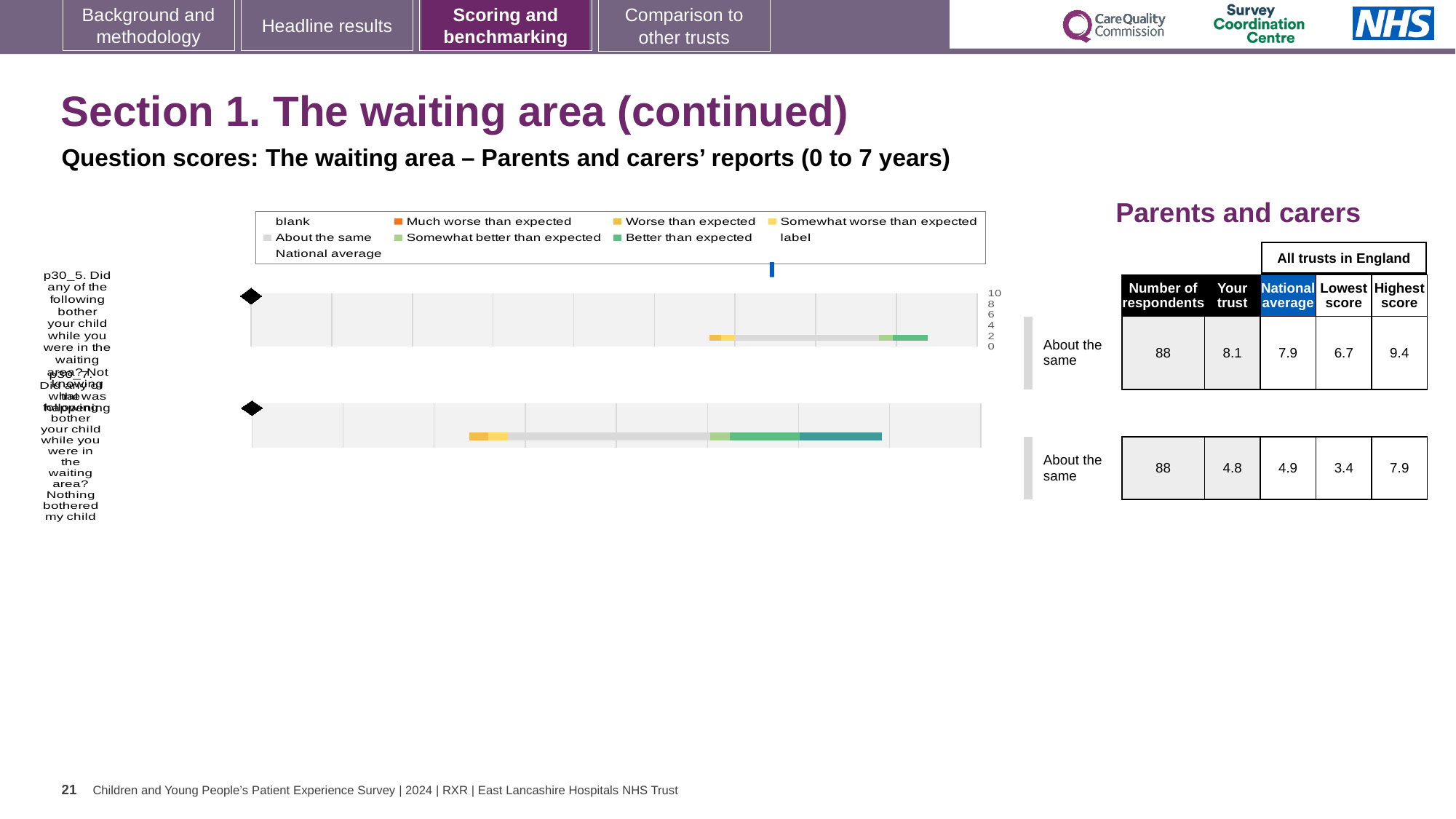
For the top chart (p30_5), what is the difference between the highest score and the lowest score across all trusts in England? 2.7 How many entries does the chart legend list? 9 How many charts are shown on the slide? 2 What colour does the legend use for 'Much worse than expected'? orange What is the highest value shown on the chart's axis? 10 How many respondents are listed for the bottom chart (p30_7, Nothing bothered my child)? 88 For the top chart (p30_5, Not knowing what was happening), what is the 'Your trust' score in the table? 8.1 What benchmark category is given for the bottom chart (p30_7, Nothing bothered my child)? About the same What kind of chart is used on this slide to show the question scores? bar chart For the top chart (p30_5), which is larger: the 'Your trust' score or the national average? Your trust For the bottom chart (p30_7, Nothing bothered my child), what is the 'Your trust' score? 4.8 For the top chart (p30_5, Not knowing what was happening), what is the national average score? 7.9